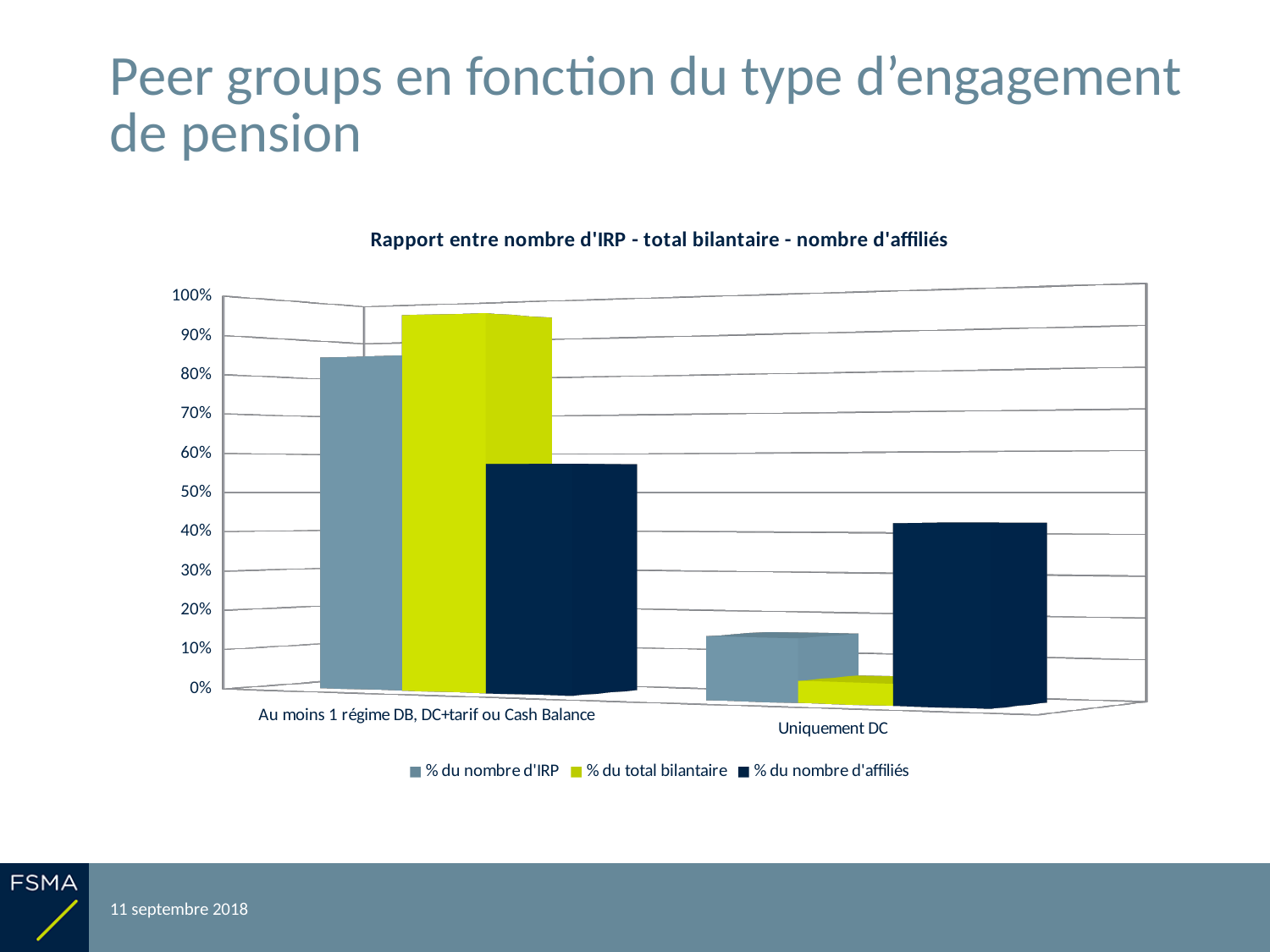
What kind of chart is shown on the slide? bar chart Which series has the highest value for 'Uniquement DC'? % du nombre d'affiliés Is the value of '% du nombre d'IRP' for 'Au moins 1 régime DB, DC+tarif ou Cash Balance' greater or less than 80%? greater Is the value of '% du nombre d'affiliés' for 'Uniquement DC' greater or less than 50%? less Which series has the highest value for 'Au moins 1 régime DB, DC+tarif ou Cash Balance'? % du total bilantaire Which series has the lowest value for 'Uniquement DC'? % du total bilantaire How many series does the legend list? 3 Is the value of '% du total bilantaire' for 'Uniquement DC' greater or less than 10%? less How many categories are shown on the x axis? 2 For '% du nombre d'affiliés', which category has the larger value: 'Au moins 1 régime DB, DC+tarif ou Cash Balance' or 'Uniquement DC'? Au moins 1 régime DB, DC+tarif ou Cash Balance Which series is shown in yellow-green? % du total bilantaire What is the title of the chart? Rapport entre nombre d'IRP - total bilantaire - nombre d'affiliés